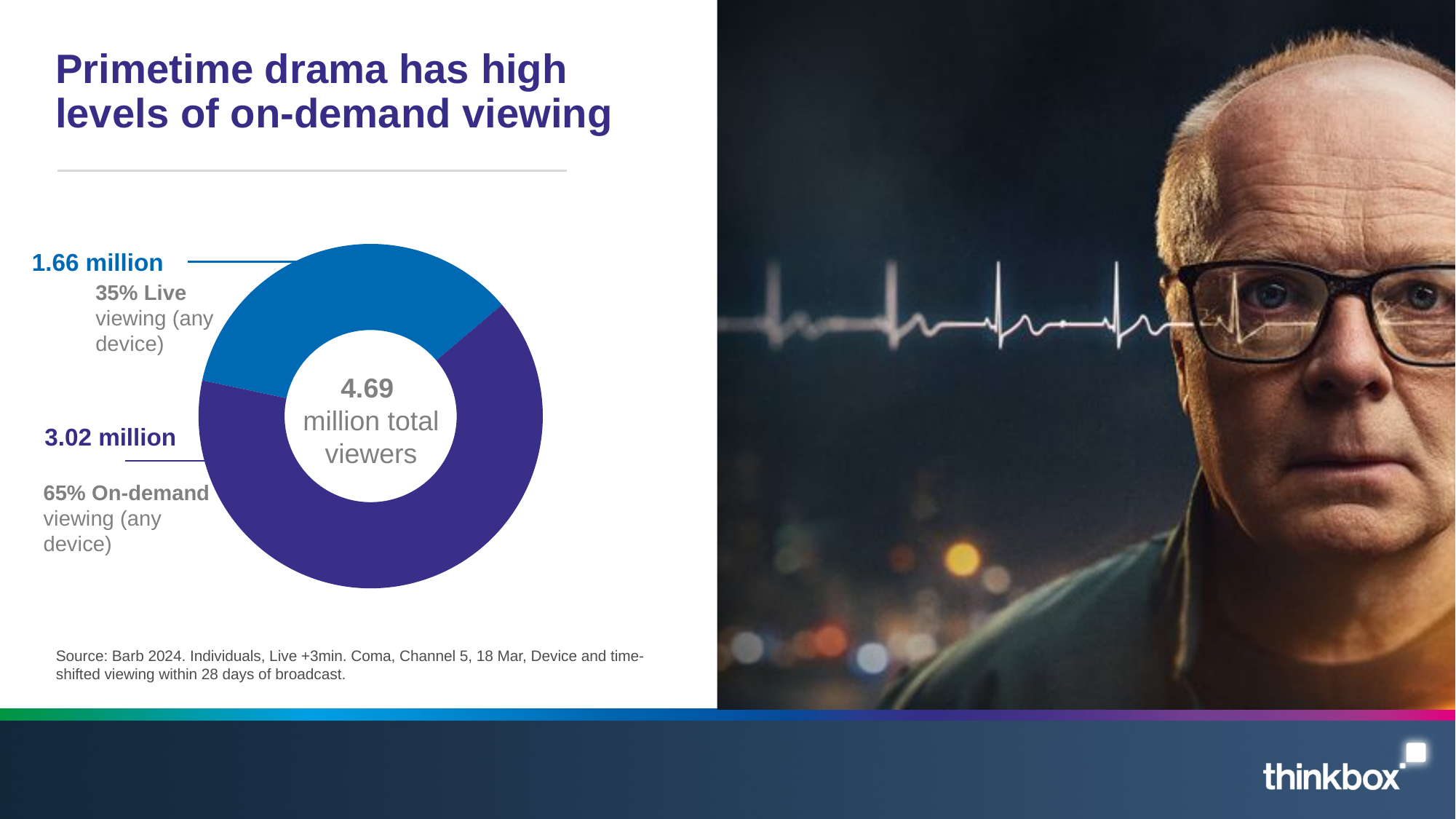
Which segment is larger, live viewing or on-demand viewing? On-demand viewing What share of viewing is on-demand viewing (any device)? 65% What is the total number of viewers shown in the centre of the chart? 4.69 million total viewers How many segments does the doughnut chart have? 2 Which segment of the chart is the smallest? Live viewing (any device) What is the difference in viewers between on-demand viewing and live viewing? 1.36 million How many viewers does the chart show for live viewing (any device)? 1.66 million What kind of chart is shown on the slide? Doughnut (pie) chart What share of viewing is live viewing (any device)? 35% What colour is the on-demand viewing segment of the chart? Purple How many viewers does the chart show for on-demand viewing (any device)? 3.02 million What is the title of the slide containing the chart? Primetime drama has high levels of on-demand viewing